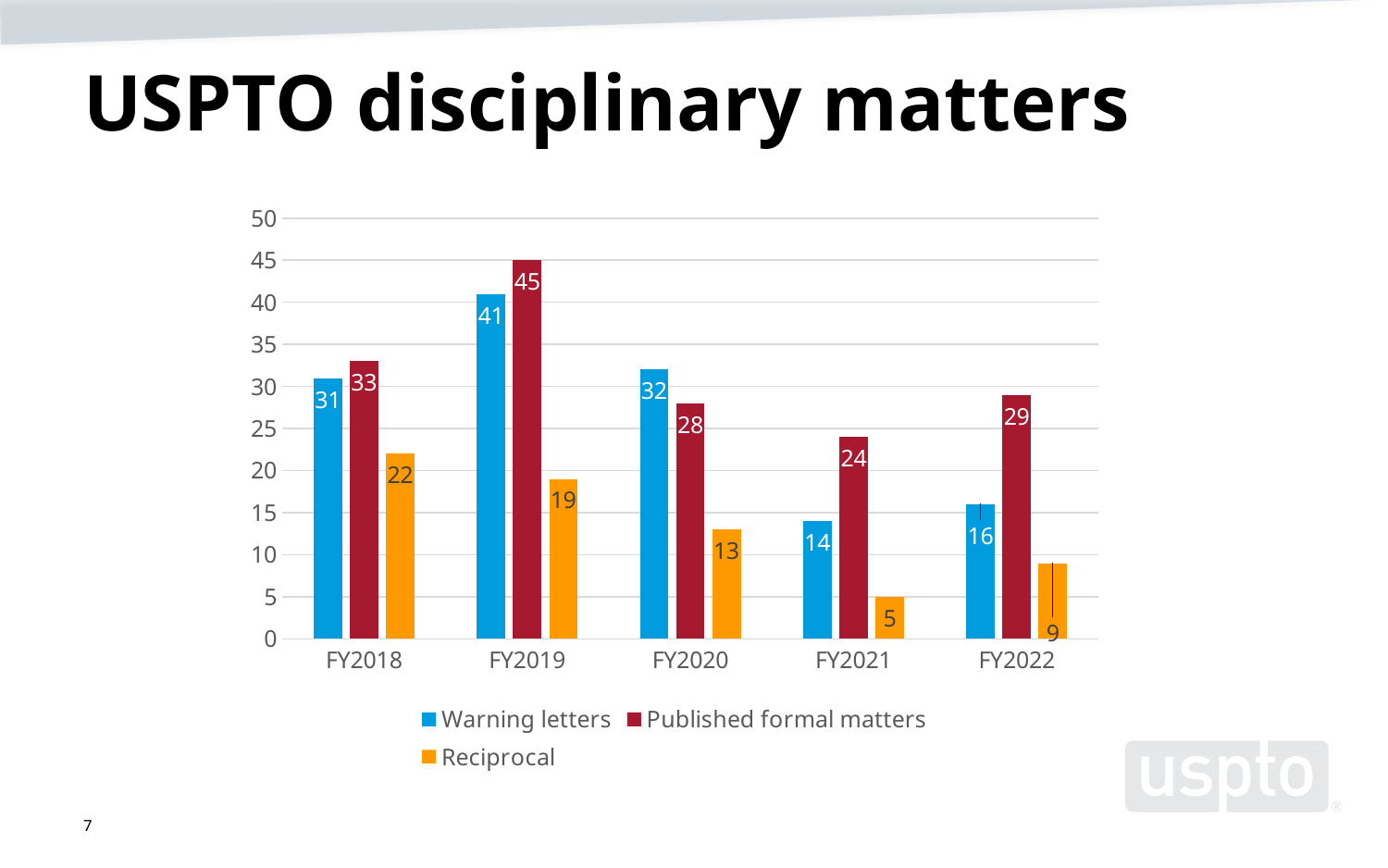
What is the value for Warning letters in FY2019? 41 How many fiscal years are shown on the x axis? 5 In which fiscal year is the Published formal matters value highest? FY2019 What is the value for Reciprocal in FY2018? 22 Which is larger in FY2020: Warning letters or Published formal matters? Warning letters What is the difference between Published formal matters and Warning letters in FY2022? 13 What is the value for Published formal matters in FY2021? 24 What is the title of the slide containing the chart? USPTO disciplinary matters What kind of chart is shown on the slide? Bar chart Do the Reciprocal values rise or fall from FY2018 to FY2021? Fall In which fiscal year is the Reciprocal value lowest? FY2021 How many series does the legend list? 3